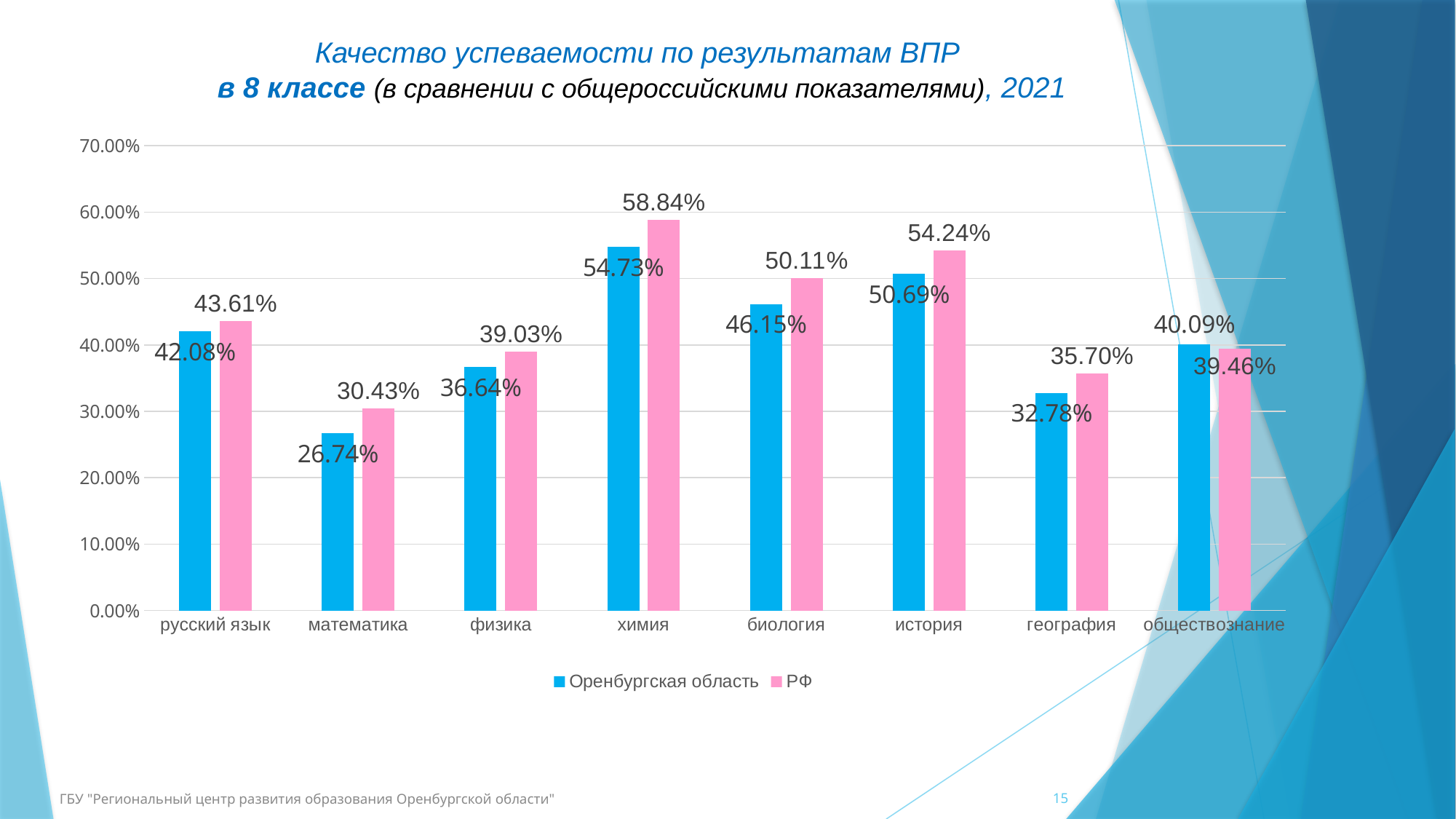
How many series does the legend list? 2 Which colour represents РФ in the chart? pink Which subject has the lowest value for Оренбургская область? математика What is the value for Оренбургская область in химия? 54.73% What is the value for РФ in математика? 30.43% Which is larger in обществознание: the value for Оренбургская область or for РФ? Оренбургская область How many subjects are shown on the x axis? 8 What is the value for Оренбургская область in обществознание? 40.09% Which subject has the highest value for РФ? химия What is the difference between the РФ and Оренбургская область values for история? 3.55% What kind of chart is shown on the slide? bar chart Is the value for Оренбургская область in география greater or less than 40.00%? less